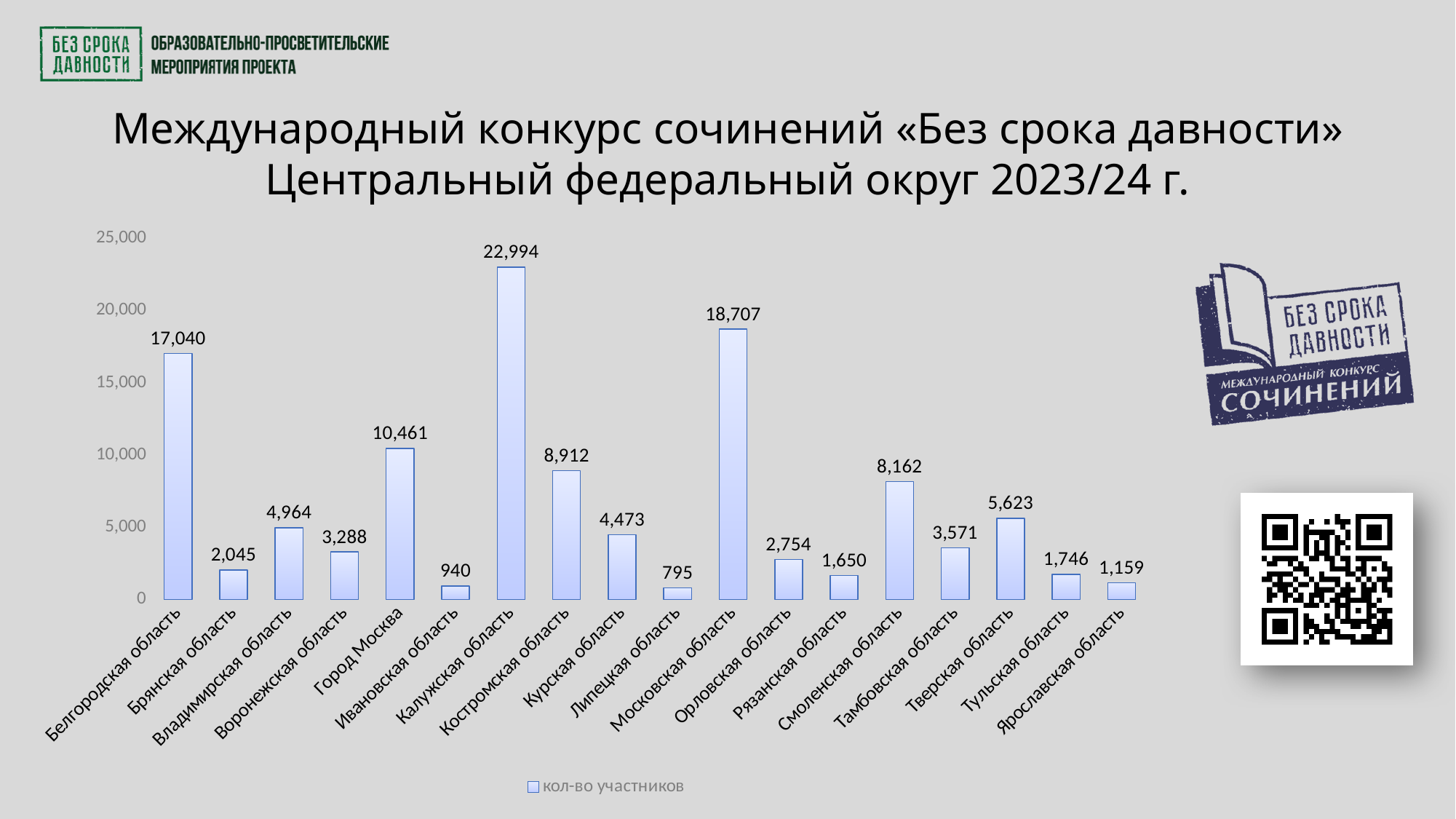
Which is larger, the value for Белгородская область or the value for Московская область? Московская область What kind of chart is shown on the slide? bar chart Is the value for Костромская область greater or less than 10,000? less Which region has the lowest value? Липецкая область Which region has the highest value? Калужская область What is the legend entry of the chart? кол-во участников How many regions are shown on the chart? 18 What is the difference between the values for Калужская область and Московская область? 4,287 What is the value for Калужская область? 22,994 How many series does the legend list? 1 What is the value for город Москва? 10,461 What is the value for Смоленская область? 8,162